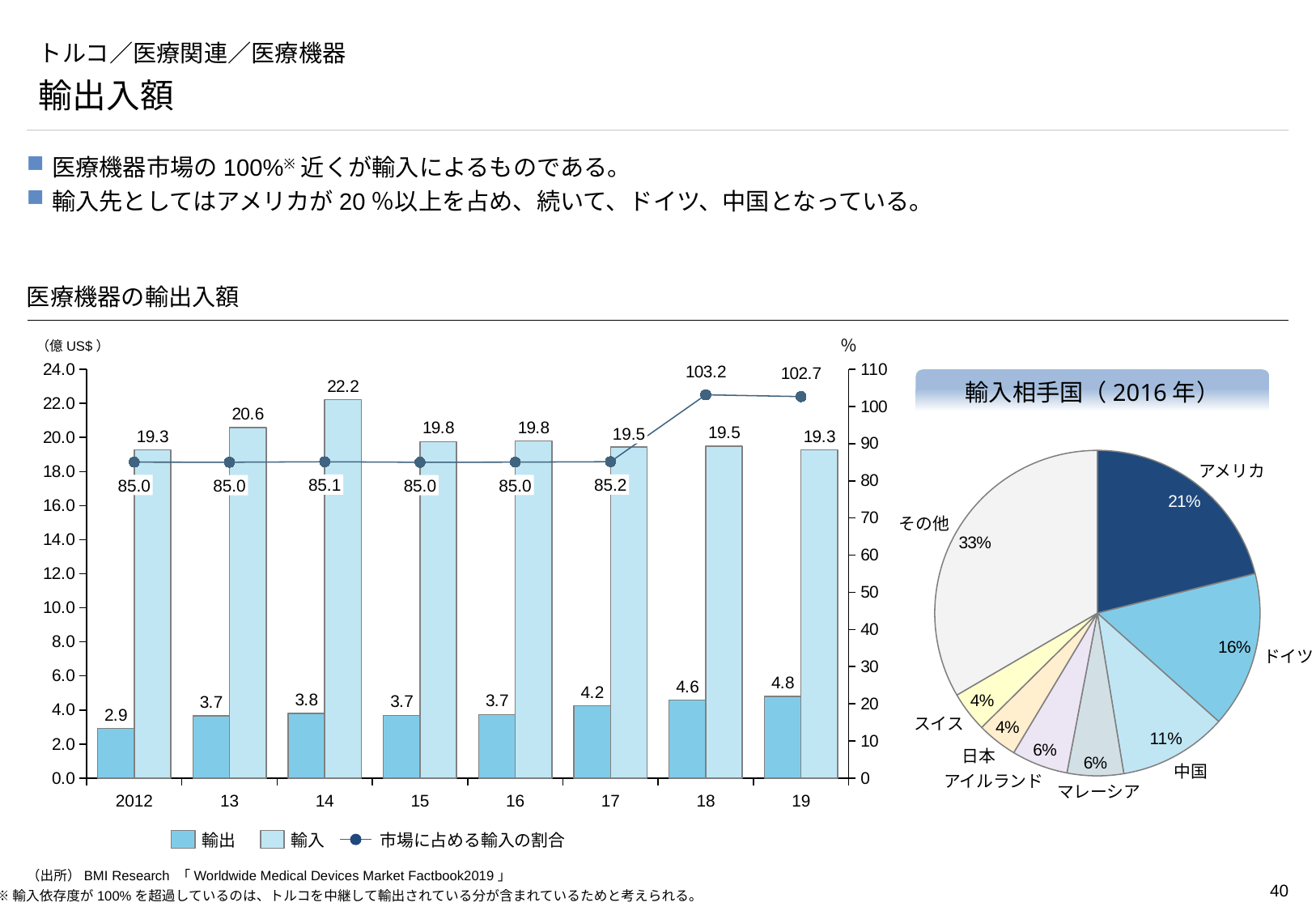
「医療機器の輸出入額」のグラフで、2012年の輸出額はいくらですか？ 2.9 「輸入相手国（2016年）」のグラフで、ドイツの割合は何%ですか？ 16% 「医療機器の輸出入額」のグラフで、輸出額は2012年から2019年にかけて全体として増加していますか、減少していますか？ 増加 「医療機器の輸出入額」のグラフで、2018年の市場に占める輸入の割合は何%ですか？ 103.2 「輸入相手国（2016年）」のグラフには、いくつの区分（国・地域）がありますか？ 8 「医療機器の輸出入額」のグラフで、輸入額が最も高い年はどれですか？ 14 「医療機器の輸出入額」のグラフで、2019年の輸入額と輸出額の差はいくらですか？ 14.5 「輸入相手国（2016年）」のグラフはどの種類のグラフですか？ 円グラフ 「医療機器の輸出入額」のグラフで、2014年の輸入額はいくらですか？ 22.2 「医療機器の輸出入額」のグラフで、凡例にはいくつの系列がありますか？ 3 「医療機器の輸出入額」のグラフで、輸出額が最も低い年はどれですか？ 2012 「輸入相手国（2016年）」のグラフで、アメリカと中国ではどちらの割合が大きいですか？ アメリカ